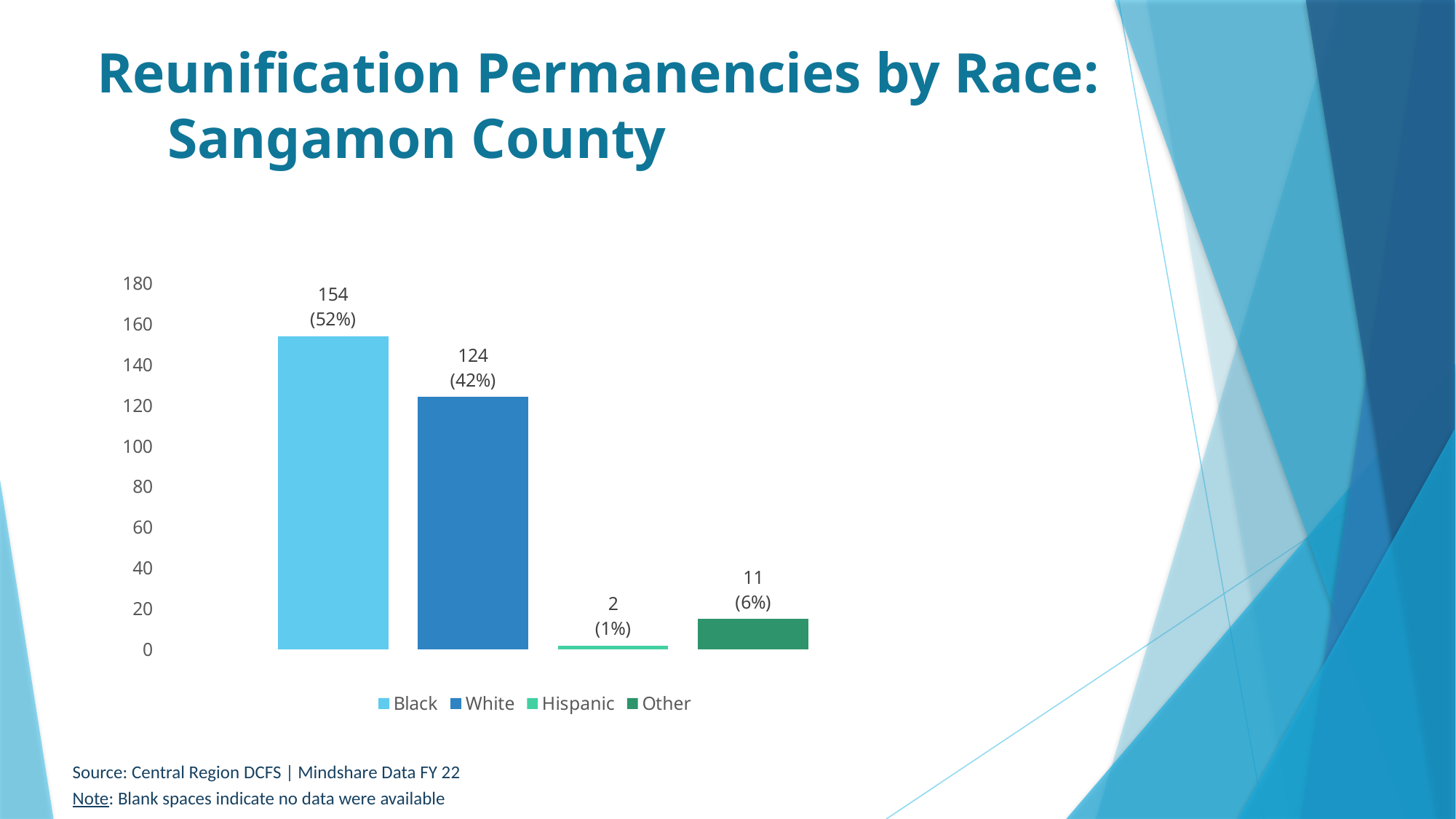
Which category has the lowest value? Hispanic Which category has the highest value? Black Which is larger, the value for Other or the value for Hispanic? Other What is the value for White? 124 What percentage is shown for Other? 6% What is the difference between the values for Black and White? 30 What is the value for Hispanic? 2 What kind of chart is shown on the slide? bar chart How many categories are plotted in the chart? 4 What is the title of the slide? Reunification Permanencies by Race: Sangamon County What is the value for Black? 154 Is the value for White greater or less than 100? greater